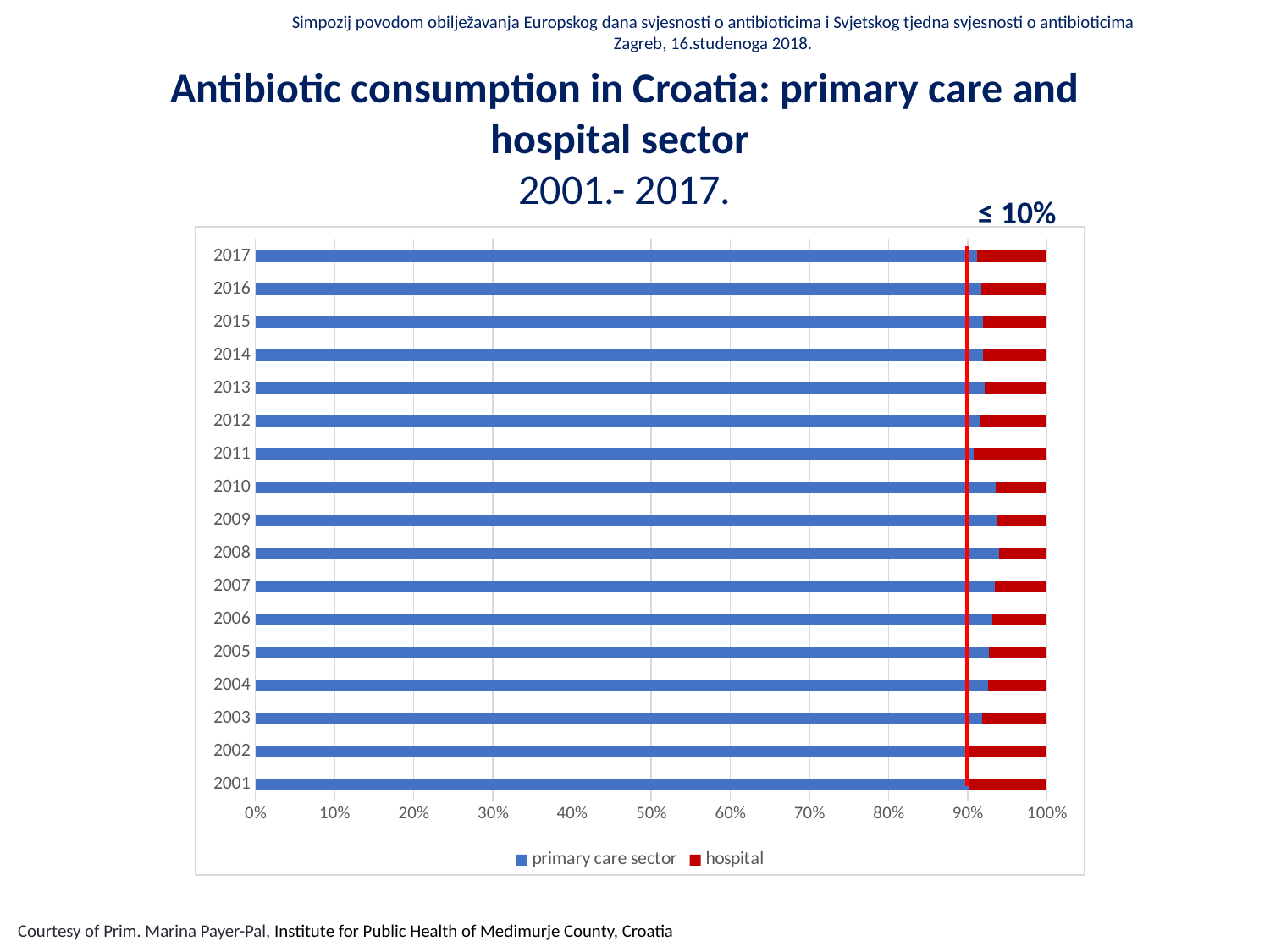
Which series is larger for 2001, primary care sector or hospital? primary care sector Is the primary care sector value for 2010 greater or less than 90%? greater What are the two series named in the legend? primary care sector and hospital Which series is larger for 2010, primary care sector or hospital? primary care sector What is the first year shown at the bottom of the chart? 2001 What kind of chart is shown on the slide? Stacked bar chart What label is written next to the red vertical line on the chart? ≤ 10% What is the total of the stacked bar for 2017? 100% Is the primary care sector value for 2005 greater or less than 80%? greater How many years are plotted on the chart? 17 Is the hospital value for 2008 greater or less than 10%? less How many series does the legend list? 2